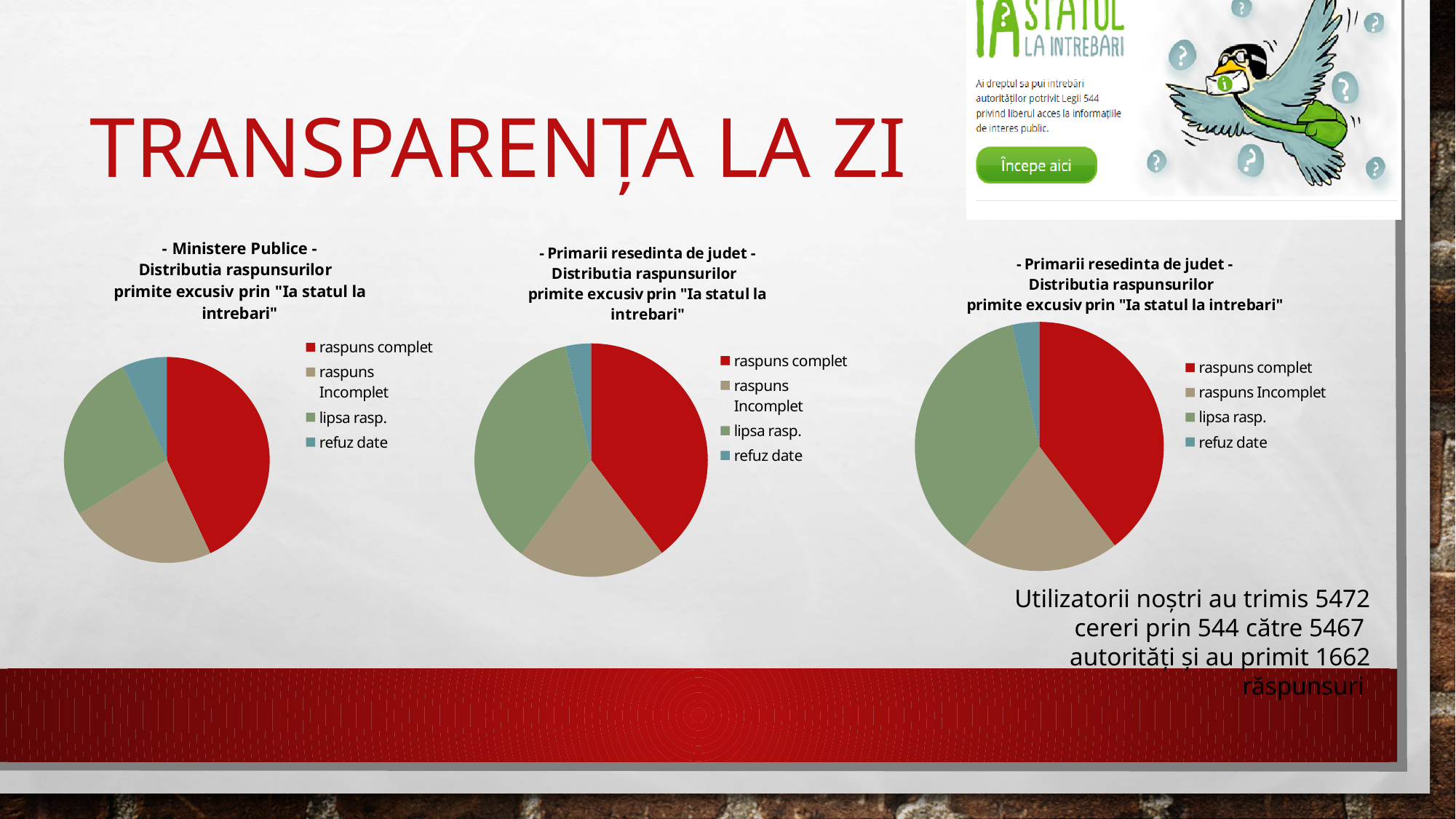
What kind of chart is the left chart (Ministere Publice)? pie chart How many pie charts are shown on the slide? 3 In the right chart, which category has the smallest slice? refuz date In the right chart, which slice is larger: lipsa rasp. or refuz date? lipsa rasp. In the right chart, which category has the largest slice? raspuns complet In the middle chart, which category has the smallest slice? refuz date In the left chart (Ministere Publice), which category has the smallest slice? refuz date In the middle chart, which slice is larger: raspuns complet or raspuns Incomplet? raspuns complet In the left chart (Ministere Publice), which slice is larger: lipsa rasp. or raspuns Incomplet? lipsa rasp. In the left chart (Ministere Publice), which category has the largest slice? raspuns complet How many entries does the legend of the left chart (Ministere Publice) list? 4 Which colour represents 'refuz date' in the legends of the charts? blue